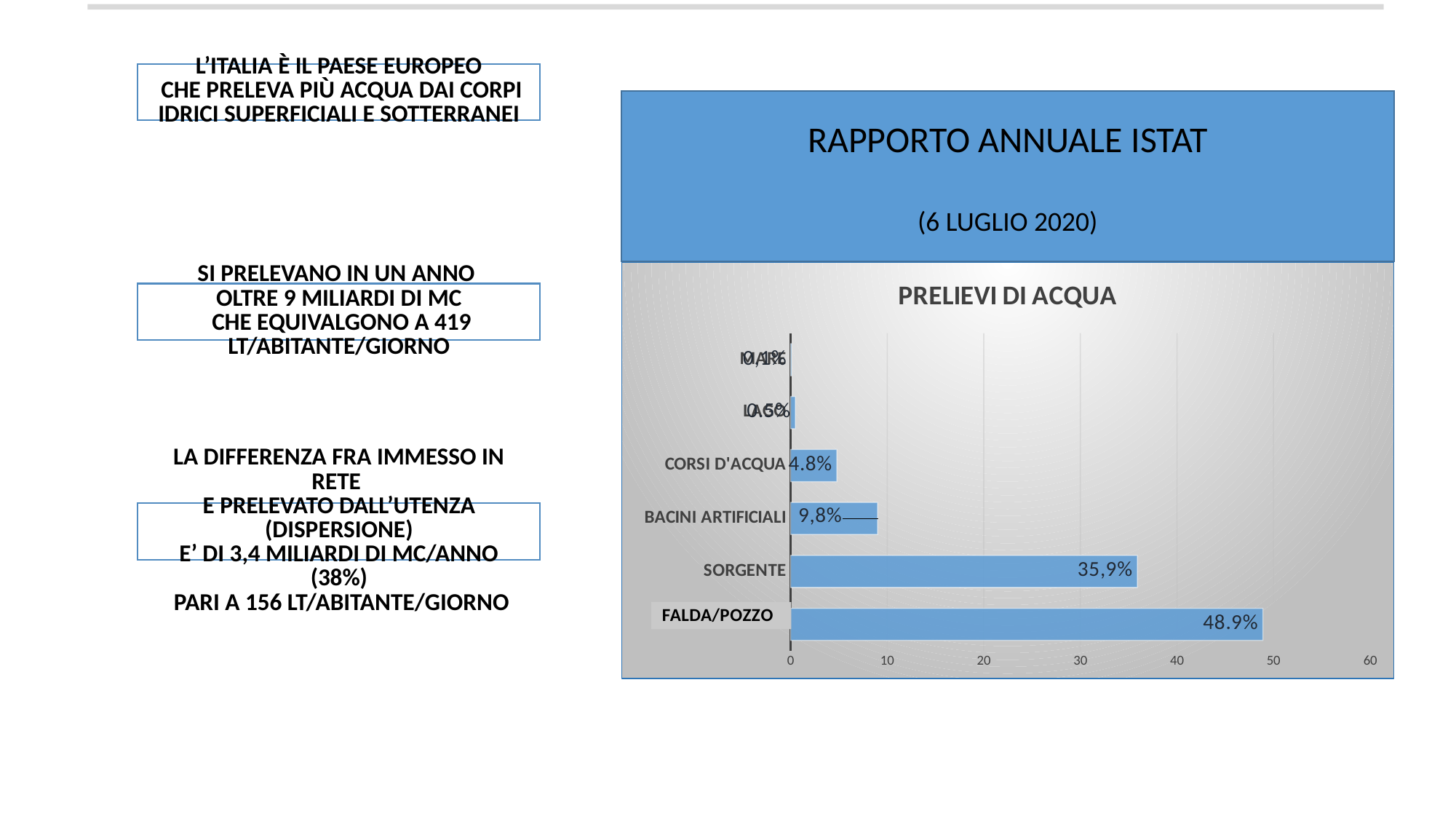
What is the value for CORSI D'ACQUA in the PRELIEVI DI ACQUA chart? 4.8% How many bars are plotted in the PRELIEVI DI ACQUA chart? 6 What is the value for SORGENTE in the PRELIEVI DI ACQUA chart? 35,9% Is the value for SORGENTE in the PRELIEVI DI ACQUA chart greater or less than 30? greater Is the value for BACINI ARTIFICIALI in the PRELIEVI DI ACQUA chart greater or less than 20? less What is the value for BACINI ARTIFICIALI in the PRELIEVI DI ACQUA chart? 9,8% What date is shown in the header above the PRELIEVI DI ACQUA chart? 6 LUGLIO 2020 Which is larger in the PRELIEVI DI ACQUA chart, SORGENTE or BACINI ARTIFICIALI? SORGENTE What is the difference between the values for FALDA/POZZO and SORGENTE in the PRELIEVI DI ACQUA chart? 13% Which category has the highest value in the PRELIEVI DI ACQUA chart? FALDA/POZZO What kind of chart is the PRELIEVI DI ACQUA chart? bar chart What is the value for FALDA/POZZO in the PRELIEVI DI ACQUA chart? 48.9%